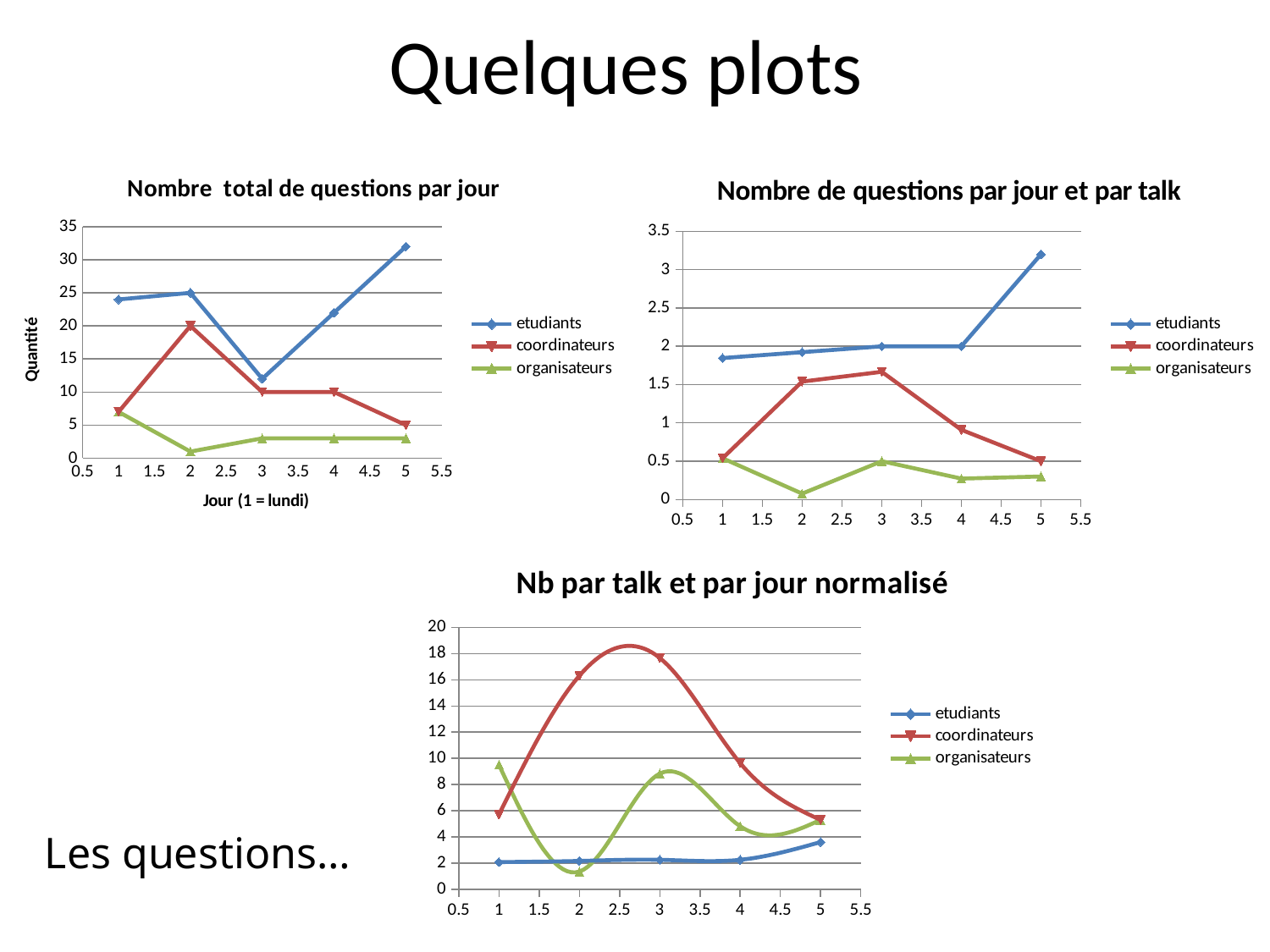
In the chart titled "Nombre de questions par jour et par talk", what is the value for etudiants on day 3? 2 In the chart titled "Nombre total de questions par jour", is the etudiants value on day 5 greater or less than 30? greater In the chart titled "Nb par talk et par jour normalisé", which series reaches the highest value? coordinateurs In the chart titled "Nombre total de questions par jour", on which day is the etudiants value highest? 5 In the chart titled "Nombre de questions par jour et par talk", is the etudiants value on day 5 greater or less than 3? greater In the chart titled "Nombre total de questions par jour", what is the value for etudiants on day 2? 25 In the chart titled "Nombre total de questions par jour", what is the value for coordinateurs on day 5? 5 In the chart titled "Nombre total de questions par jour", which series is larger on day 3, etudiants or coordinateurs? etudiants In the chart titled "Nombre total de questions par jour", what is the value for coordinateurs on day 2? 20 How many series does the legend of the chart titled "Nombre de questions par jour et par talk" list? 3 What is the x-axis label of the chart titled "Nombre total de questions par jour"? Jour (1 = lundi) In the chart titled "Nb par talk et par jour normalisé", is the coordinateurs value on day 2 greater or less than 14? greater